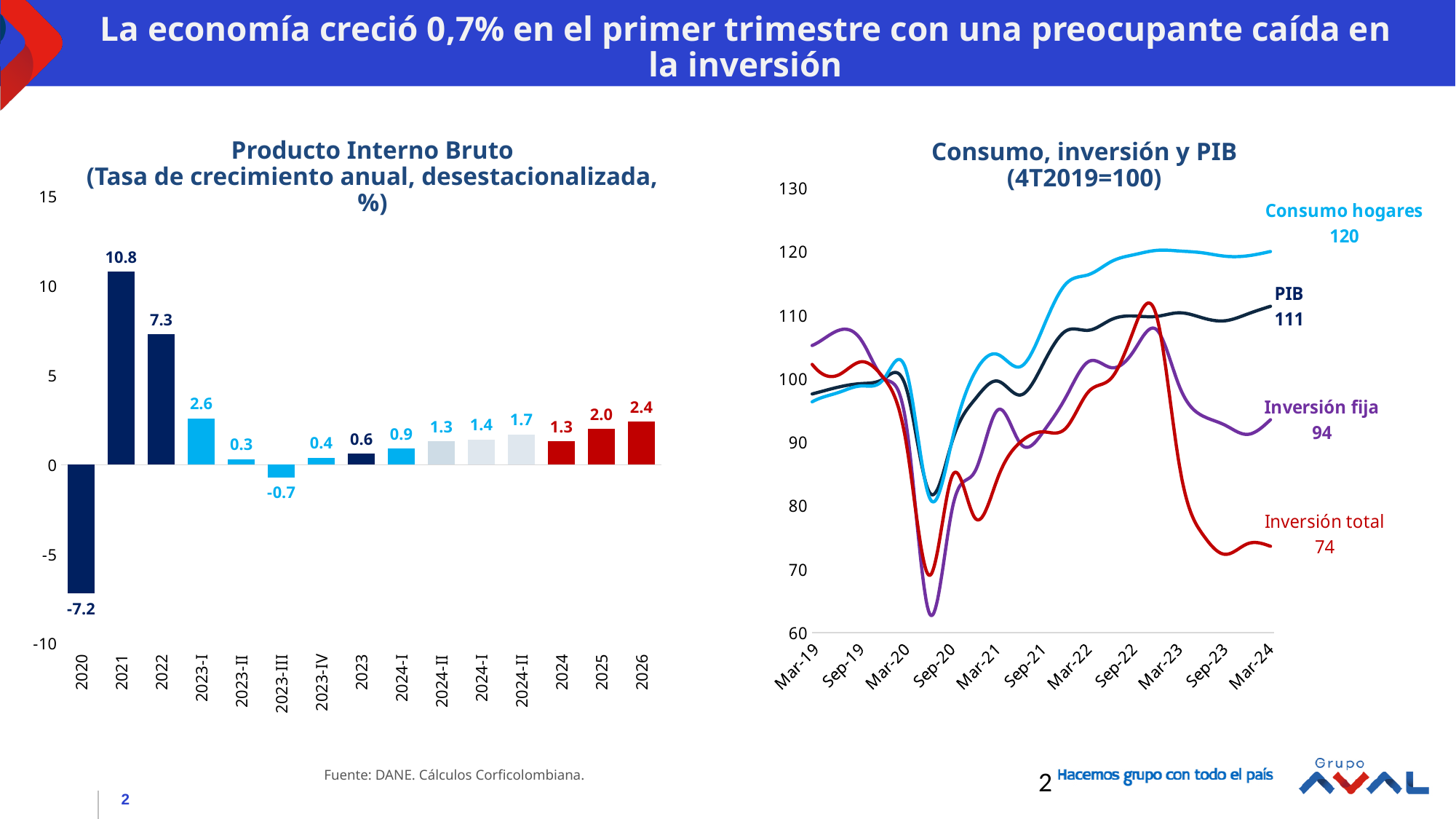
What kind of chart is the Producto Interno Bruto chart on the left? Bar chart In the Producto Interno Bruto chart, what is the difference between the values for 2021 and 2022? 3.5 In the Producto Interno Bruto chart, what is the growth rate for 2020? -7.2 What kind of chart is the Consumo, inversión y PIB chart on the right? Line chart In the Consumo, inversión y PIB chart, what is the final value shown for Consumo hogares? 120 How many series are plotted in the Consumo, inversión y PIB chart? 4 In the Producto Interno Bruto chart, which is larger, the value for 2025 or for 2026? 2026 In the Producto Interno Bruto chart, which category has the highest value? 2021 How many bars are plotted in the Producto Interno Bruto chart? 15 In the Consumo, inversión y PIB chart, what is the final value shown for Inversión total? 74 In the Producto Interno Bruto chart, which category has the lowest value? 2020 In the Producto Interno Bruto chart, what is the growth rate for 2021? 10.8